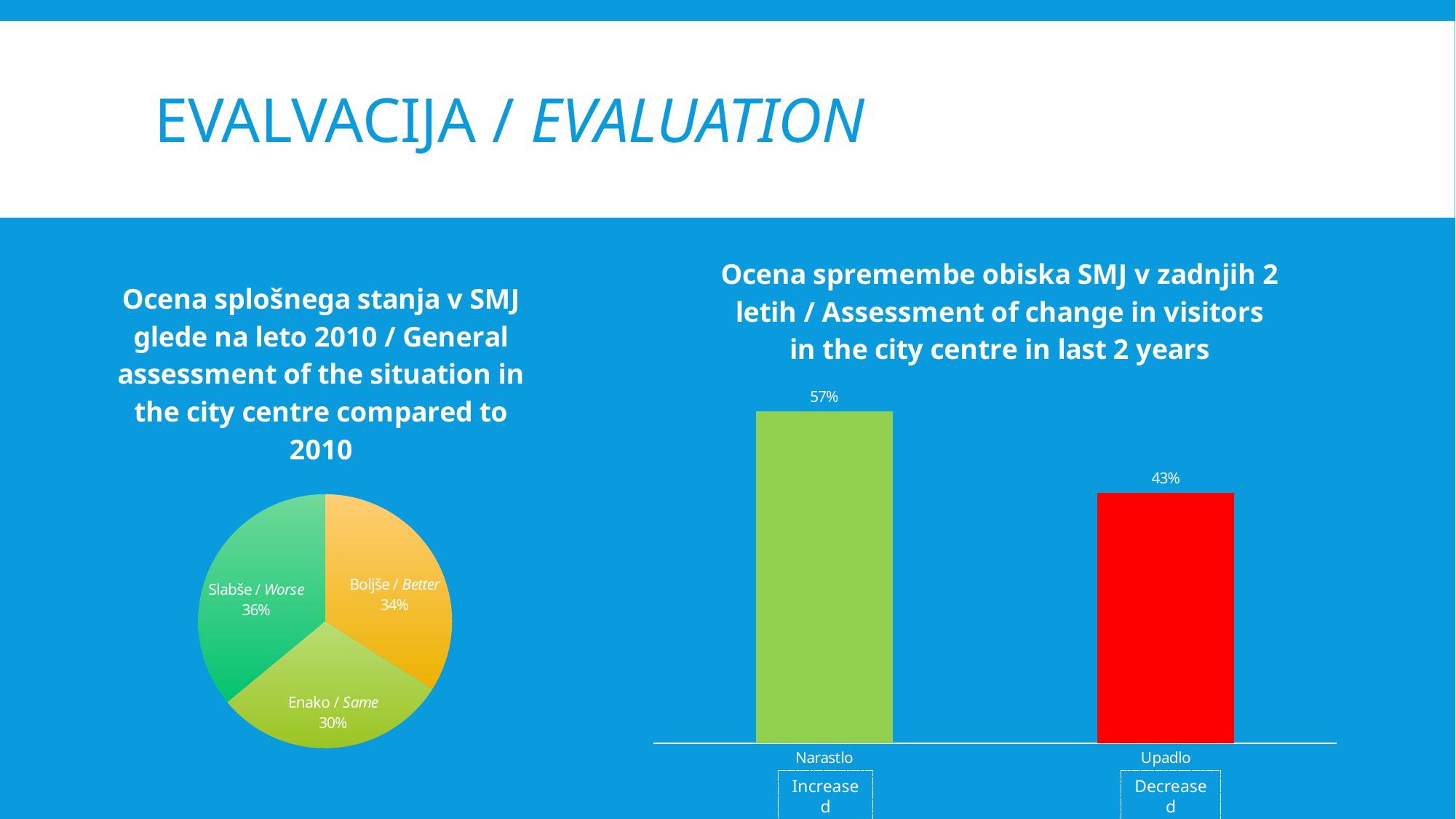
In the pie chart on the left, which category has the largest share? Slabše / Worse In the bar chart on the right, what is the difference between the Narastlo and Upadlo values? 14% In the pie chart on the left, what share is labelled Boljše / Better? 34% In the pie chart on the left, what share is labelled Enako / Same? 30% In the bar chart on the right, which category has the higher value, Narastlo or Upadlo? Narastlo In the pie chart on the left, how many slices are there? 3 In the pie chart on the left, what is the difference between the Slabše / Worse share and the Enako / Same share? 6% In the bar chart on the right, what is the value for Upadlo (Decreased)? 43% In the pie chart on the left, which category has the smallest share? Enako / Same In the bar chart on the right, what is the value for Narastlo (Increased)? 57% What type of chart is shown on the right side of the slide? Bar chart In the pie chart on the left, what share is labelled Slabše / Worse? 36%